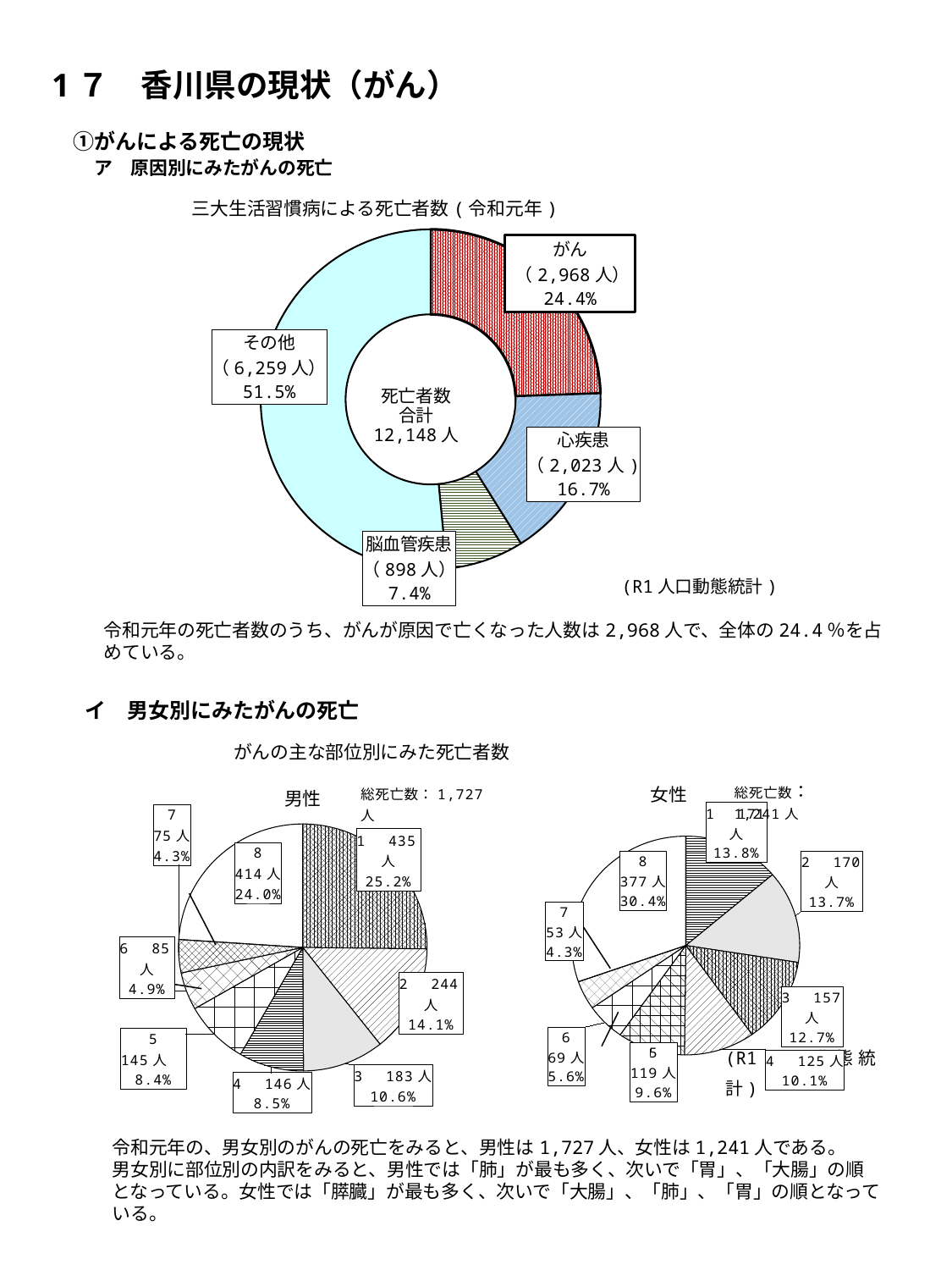
In the donut chart titled 三大生活習慣病による死亡者数（令和元年）, what is the total number of deaths shown in the centre? 12,148人 In the donut chart titled 三大生活習慣病による死亡者数（令和元年）, which category has the smallest share? 脳血管疾患 In the donut chart titled 三大生活習慣病による死亡者数（令和元年）, what is the difference in deaths between がん and 心疾患? 945人 In the 女性 pie chart under がんの主な部位別にみた死亡者数, which has more deaths, category 3 or category 4? category 3 In the 女性 pie chart under がんの主な部位別にみた死亡者数, what percentage share does category 8 have? 30.4% In the 男性 pie chart under がんの主な部位別にみた死亡者数, how many deaths are in category 1? 435人 In the donut chart titled 三大生活習慣病による死亡者数（令和元年）, what percentage share does 心疾患 have? 16.7% In the donut chart titled 三大生活習慣病による死亡者数（令和元年）, how many categories are shown? 4 In the 男性 pie chart under がんの主な部位別にみた死亡者数, what is the total number of deaths (総死亡数)? 1,727人 In the donut chart titled 三大生活習慣病による死亡者数（令和元年）, how many deaths are attributed to がん? 2,968人 In the 男性 pie chart under がんの主な部位別にみた死亡者数, which numbered category has the fewest deaths? 7 What kind of chart is used for 三大生活習慣病による死亡者数（令和元年）? donut (pie) chart